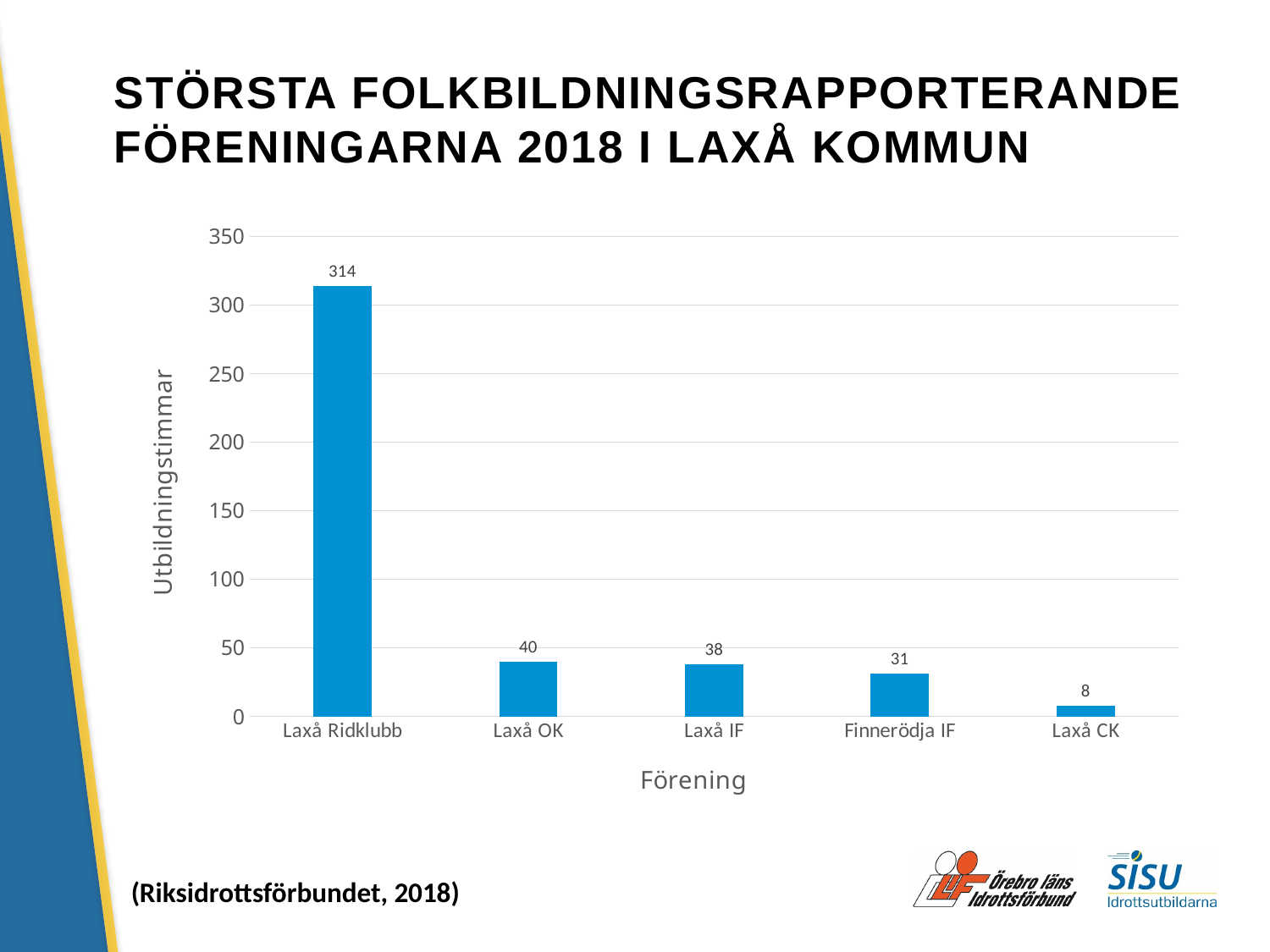
What is the value for Finnerödja IF? 31 Which förening has the lowest number of utbildningstimmar? Laxå CK How many föreningar are shown in the chart? 5 Is the value for Laxå Ridklubb greater or less than 300? greater What kind of chart is shown on the slide? bar chart Which förening has the highest number of utbildningstimmar? Laxå Ridklubb What is the value for Laxå Ridklubb? 314 What is the value for Laxå OK? 40 What is the difference between the values for Laxå Ridklubb and Laxå OK? 274 What is the difference between the values for Laxå IF and Laxå CK? 30 Which is larger, the value for Laxå OK or the value for Finnerödja IF? Laxå OK What is the value for Laxå CK? 8